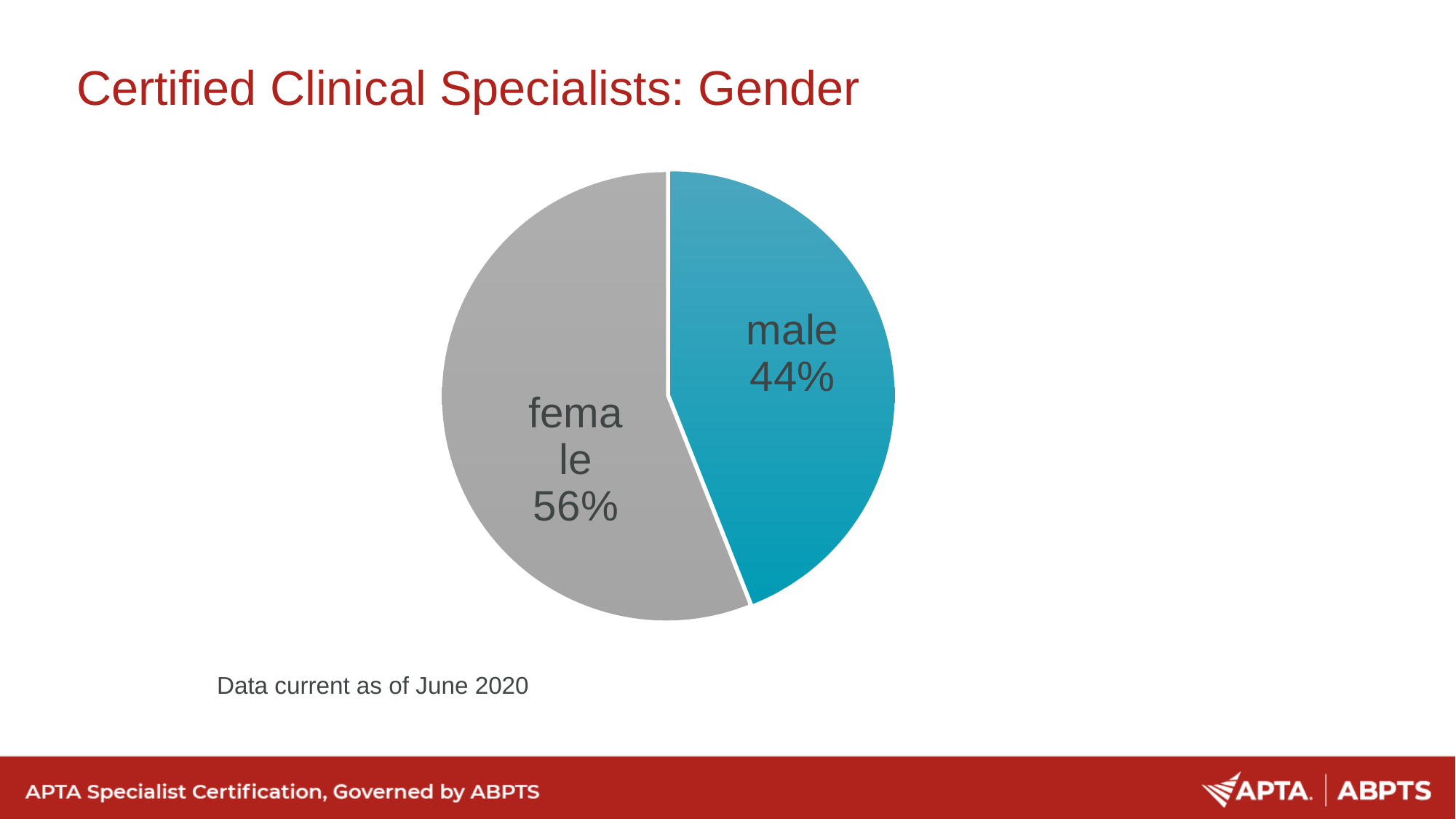
Which gender has the larger share of certified clinical specialists? female What is the difference in percentage points between the female and male shares? 12 What percentage of certified clinical specialists are male? 44% How many slices does the pie chart have? 2 What percentage of certified clinical specialists are female? 56% Is the male share greater or less than 50%? less What colour is the male slice of the pie chart? teal/blue What share of the pie does the male slice represent? 44% Is the female share larger or smaller than the male share? larger What kind of chart is shown on the slide? pie chart Which gender has the smaller share of certified clinical specialists? male What is the title of the slide containing the chart? Certified Clinical Specialists: Gender